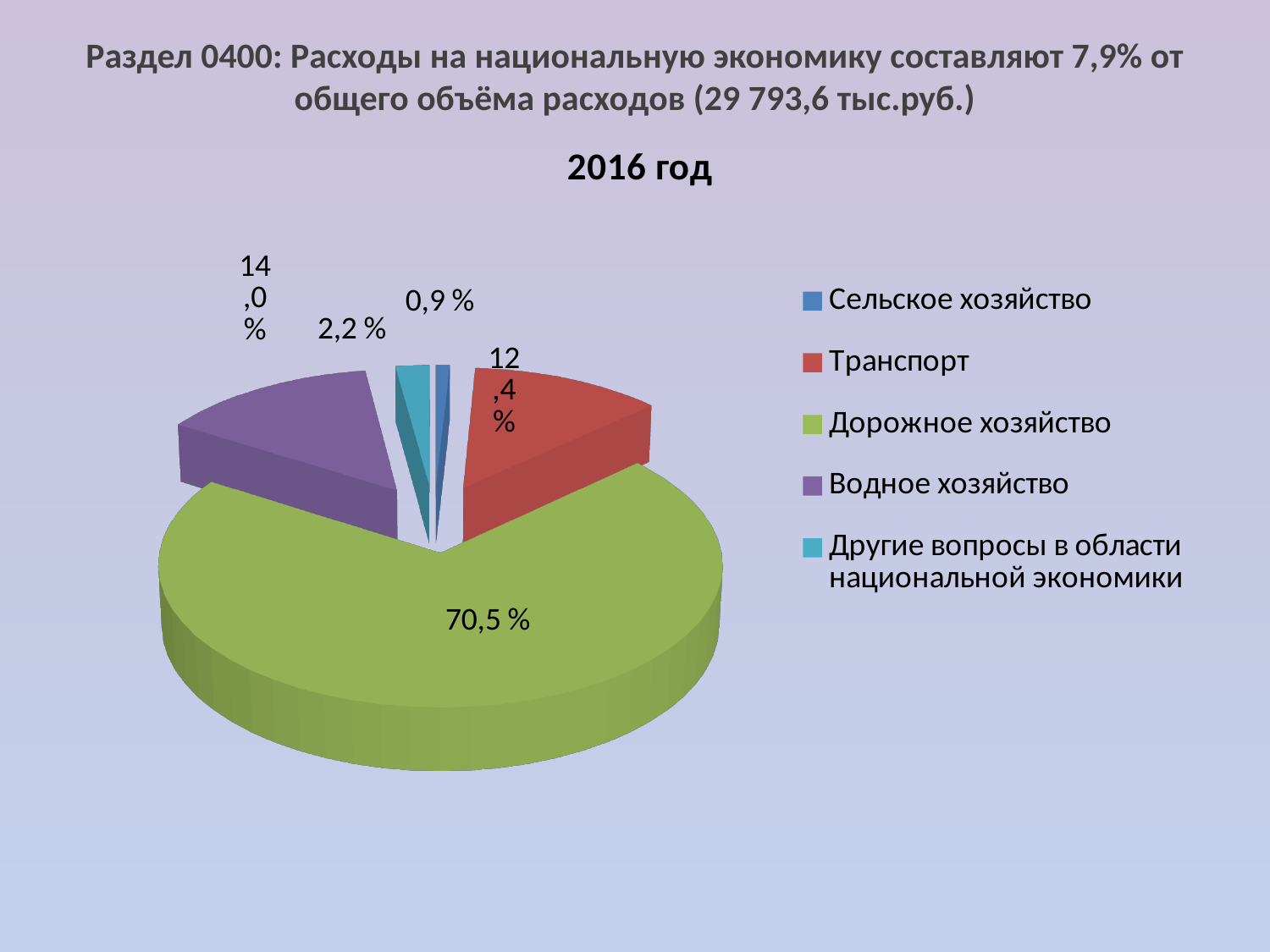
What type of chart is shown on the slide? pie chart Which category has the largest slice of the pie? Дорожное хозяйство Which is larger, the slice for Водное хозяйство or the slice for Транспорт? Водное хозяйство What share of the pie does Сельское хозяйство have? 0,9 % What share of the pie does Водное хозяйство have? 14,0 % How many categories does the legend list? 5 What share of the pie does Транспорт have? 12,4 % What is the difference in percentage points between the Дорожное хозяйство slice and the Транспорт slice? 58,1 Which category has the smallest slice of the pie? Сельское хозяйство What is the title of the chart? 2016 год What share of the pie does Другие вопросы в области национальной экономики have? 2,2 % What share of the pie does Дорожное хозяйство have? 70,5 %